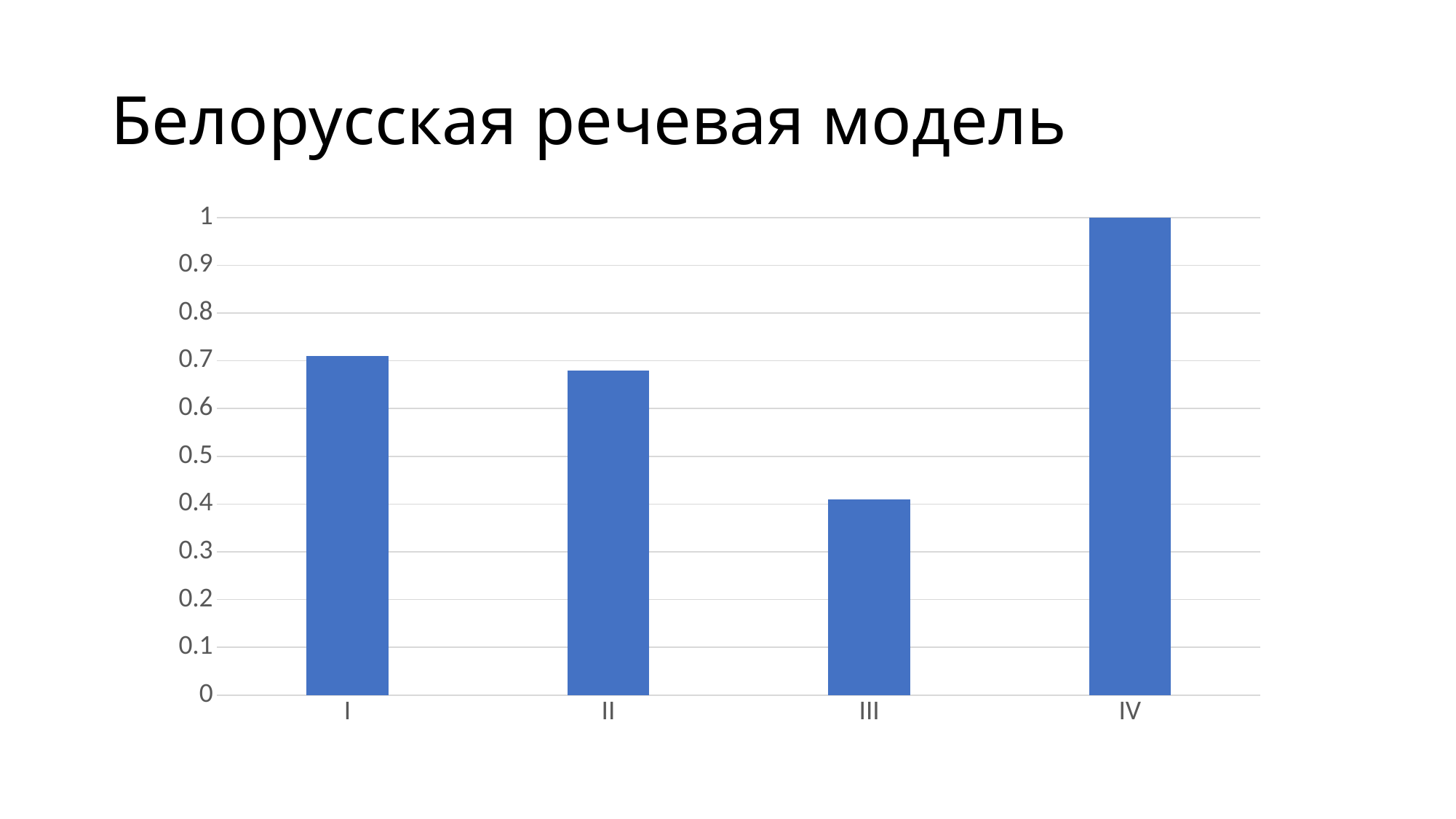
Is the value for category III greater or less than 0.3? greater Which category has the lowest value? III Is the value for category I greater or less than 0.6? greater What is the title of the slide? Белорусская речевая модель Do the values rise or fall from category I to category III? fall Which is larger, the value for category I or category III? I What kind of chart is shown on the slide? bar chart What is the value for category IV? 1 Which category has the highest value? IV How many categories are shown on the x axis? 4 Is the value for category II greater or less than 0.8? less